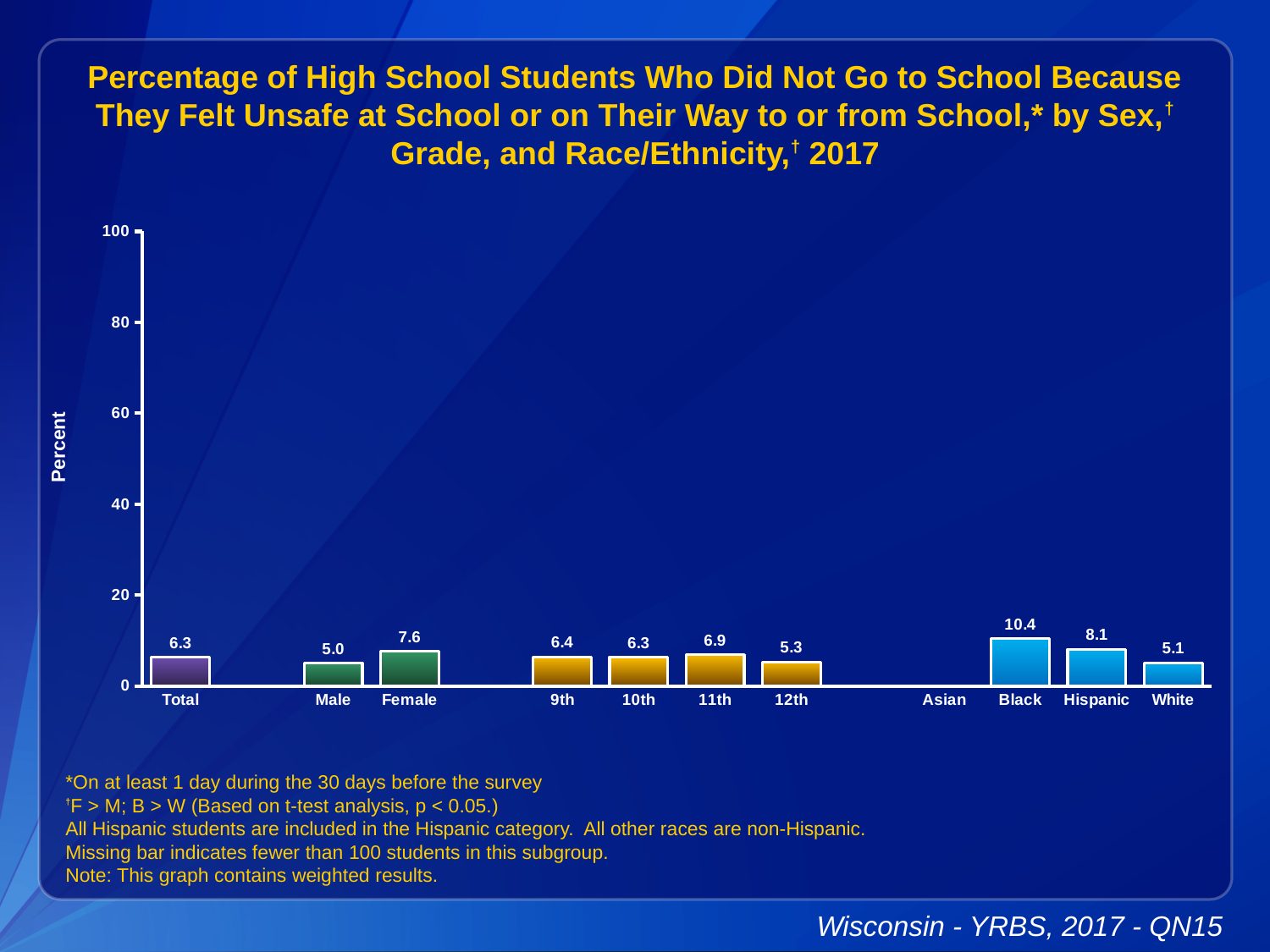
What is the value for Black? 10.4 What is the difference between the Female and Male values? 2.6 What is the difference between the Black and White values? 5.3 What is the value for Total? 6.3 Is the value for Black greater or less than 20? less Which category has the highest value? Black What is the value for 12th grade? 5.3 What kind of chart is shown? bar chart Which category has no bar shown? Asian Which grade has the lowest value? 12th Which is larger, the value for Hispanic or the value for White? Hispanic What is the value for Female? 7.6